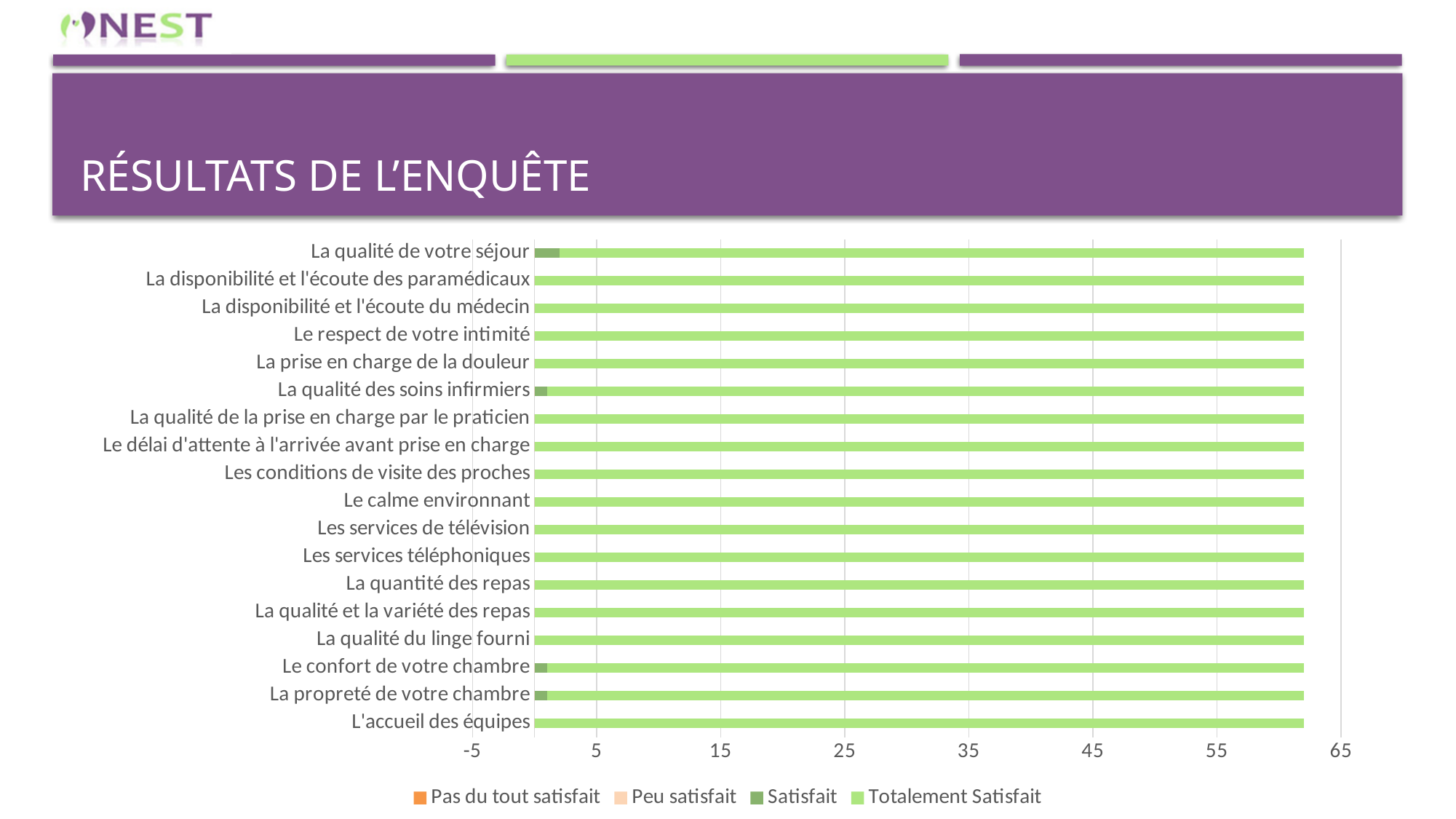
What kind of chart is shown on the slide? bar chart How many series does the chart legend list? 4 How many categories are plotted on the chart? 18 Is the 'Totalement Satisfait' value for 'Le calme environnant' greater or less than 65? less Which series is shown in light green in the legend? Totalement Satisfait What is the title of the slide containing the chart? RÉSULTATS DE L'ENQUÊTE Is the 'Totalement Satisfait' value for 'L'accueil des équipes' greater or less than 55? greater Is the 'Totalement Satisfait' value for 'La quantité des repas' greater or less than 45? greater Which category has the largest 'Satisfait' segment? La qualité de votre séjour Which is larger: the 'Satisfait' value for 'La qualité de votre séjour' or for 'La qualité des soins infirmiers'? La qualité de votre séjour